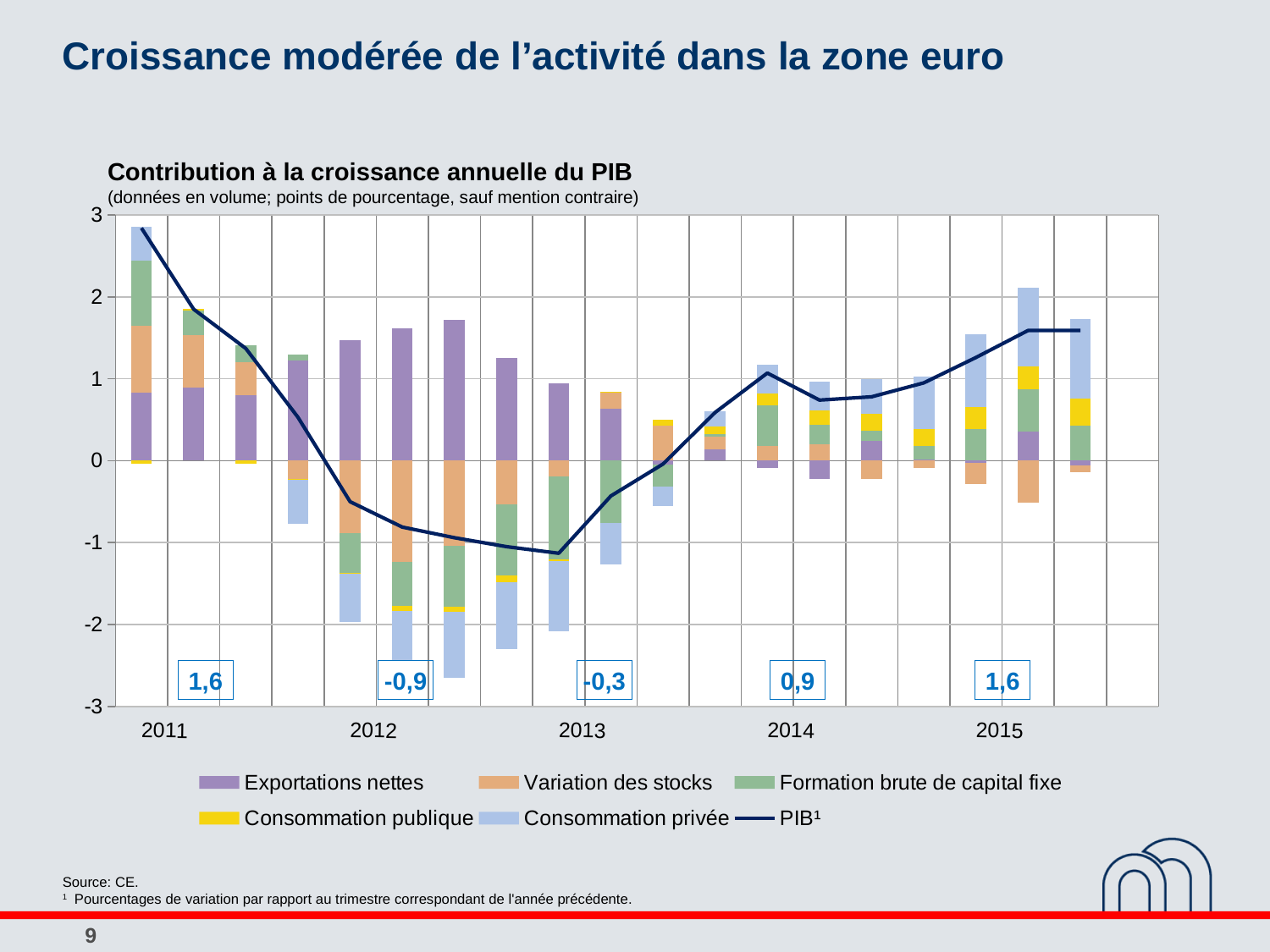
How many years are labelled on the x axis? 5 Which year has the larger printed annual value, 2013 or 2014? 2014 Does the PIB line rise or fall from the start of 2011 to the end of 2013? Fall Is the PIB line value at the first bar of 2011 greater or less than 2? greater What annual PIB growth value is printed for 2014? 0,9 What is the title of the chart? Contribution à la croissance annuelle du PIB What kind of chart is shown on the slide? A stacked bar chart with a line What annual PIB growth value is printed for 2013? -0,3 What is the difference between the printed annual values for 2015 and 2014? 0,7 How many series does the chart legend list? 6 What annual PIB growth value is printed for 2012? -0,9 Which year has the lowest printed annual PIB growth value? 2012